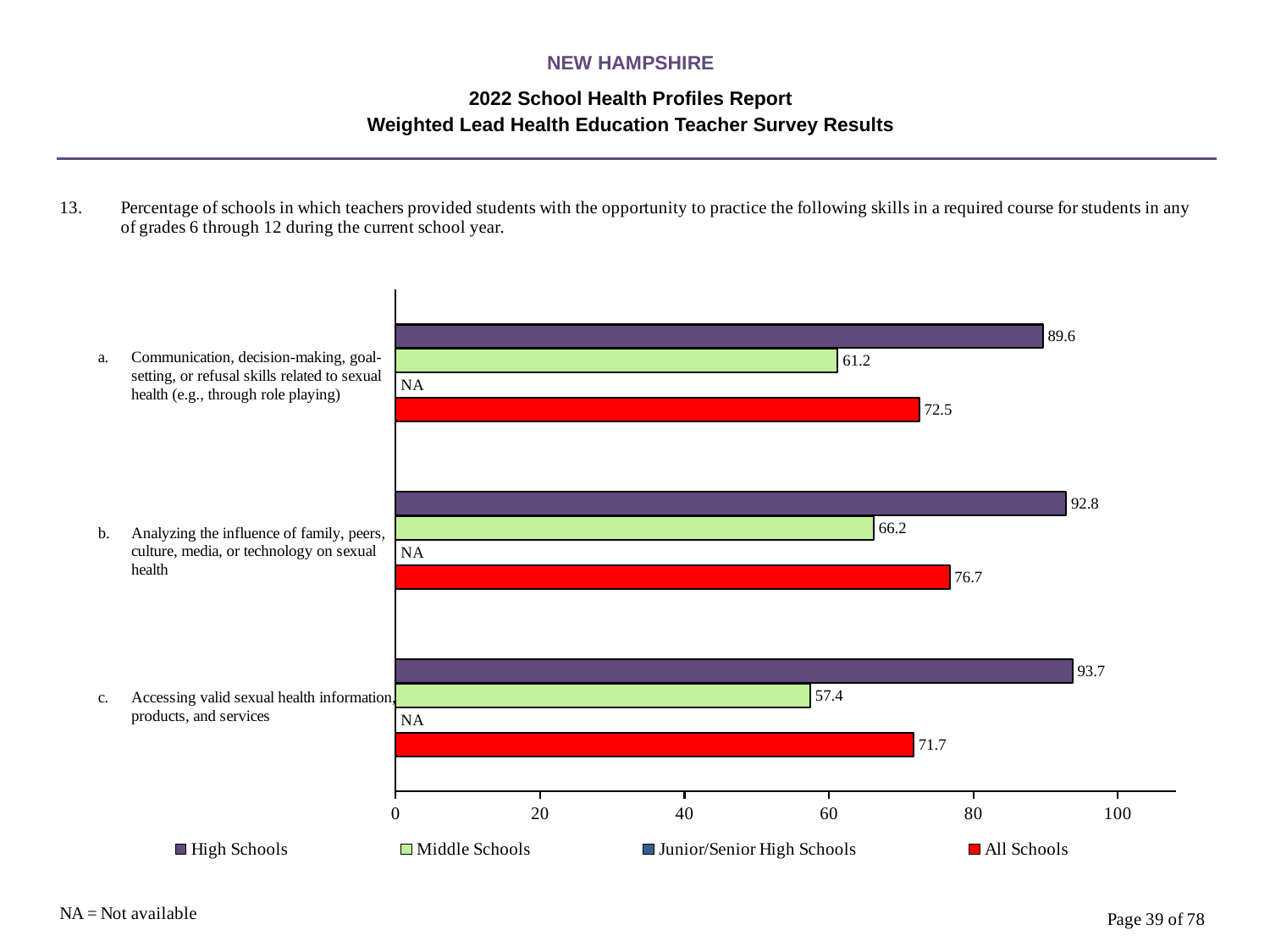
What is the value for Middle Schools for item b (Analyzing the influence of family, peers, culture, media, or technology on sexual health)? 66.2 Which is larger for item b: the All Schools value or the Middle Schools value? All Schools What kind of chart is shown on the slide? Bar chart How many series does the legend list? 4 What is the value for All Schools for item c (Accessing valid sexual health information, products, and services)? 71.7 What value is shown for Junior/Senior High Schools for item a? NA How many items (categories) are shown on the chart? 3 Which item has the lowest Middle Schools value? c. Accessing valid sexual health information, products, and services What colour represents All Schools in the legend? Red Which item has the highest High Schools value? c. Accessing valid sexual health information, products, and services What is the difference between the High Schools and Middle Schools values for item a? 28.4 What is the value for High Schools for item a (Communication, decision-making, goal-setting, or refusal skills related to sexual health)? 89.6